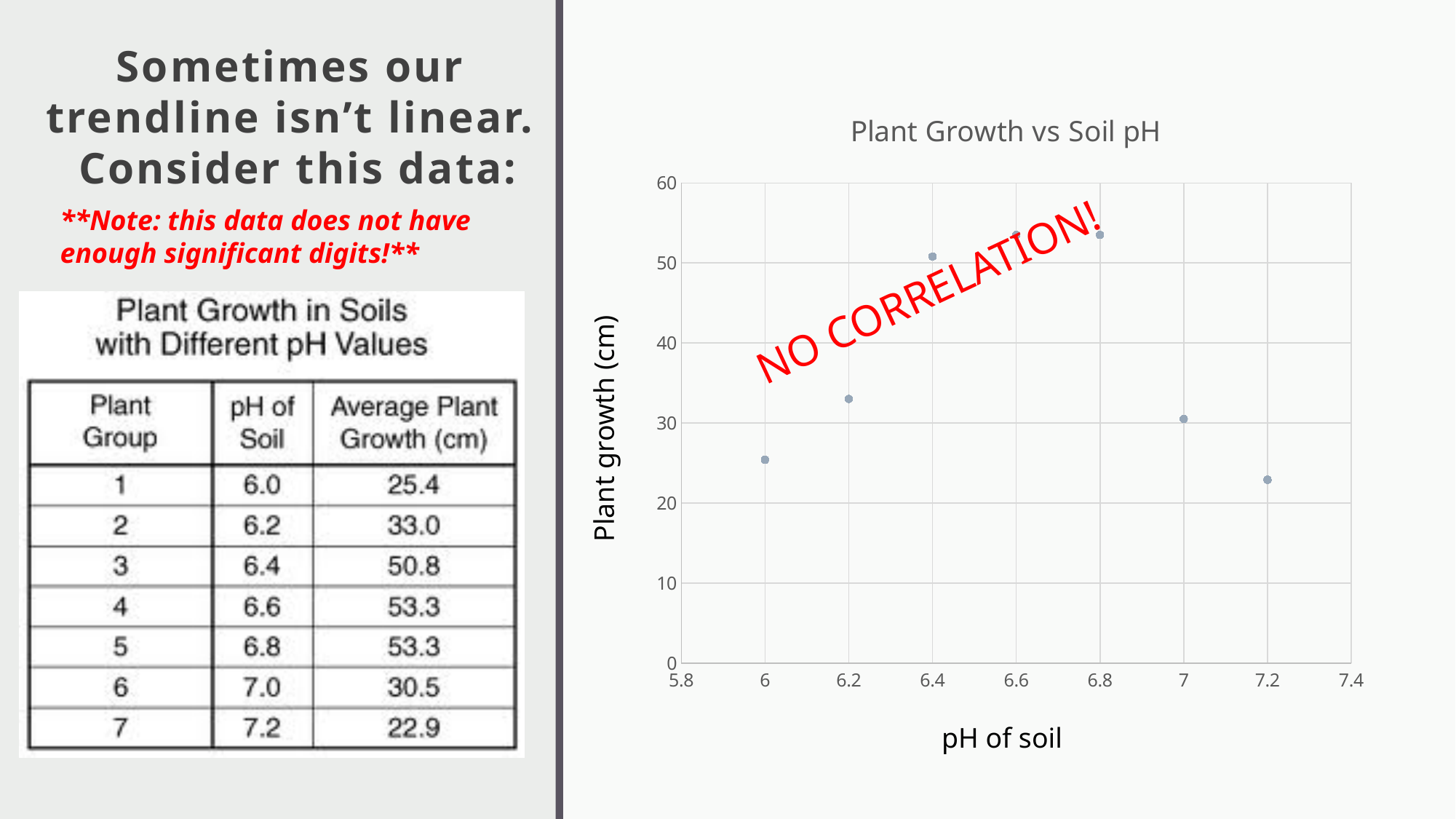
Is the plant growth at pH 7.2 greater or less than 30? less Is the plant growth at pH 6.2 greater or less than 30? greater How does plant growth change as pH increases from 6.0 to 7.2? rises then falls What kind of chart is shown on the slide? scatter chart What is the title of the chart? Plant Growth vs Soil pH At which pH value is the plant growth lowest? 7.2 How many data points are plotted on the chart? 7 What is the difference in plant growth between pH 6.6 and pH 6.0, using the values on the slide? 27.9 According to the slide, what is the plant growth at a soil pH of 6.4? 50.8 According to the slide, what is the plant growth at a soil pH of 7.2? 22.9 Which has the higher plant growth, pH 6.0 or pH 6.4? pH 6.4 What is the label of the y axis of the chart? Plant growth (cm)